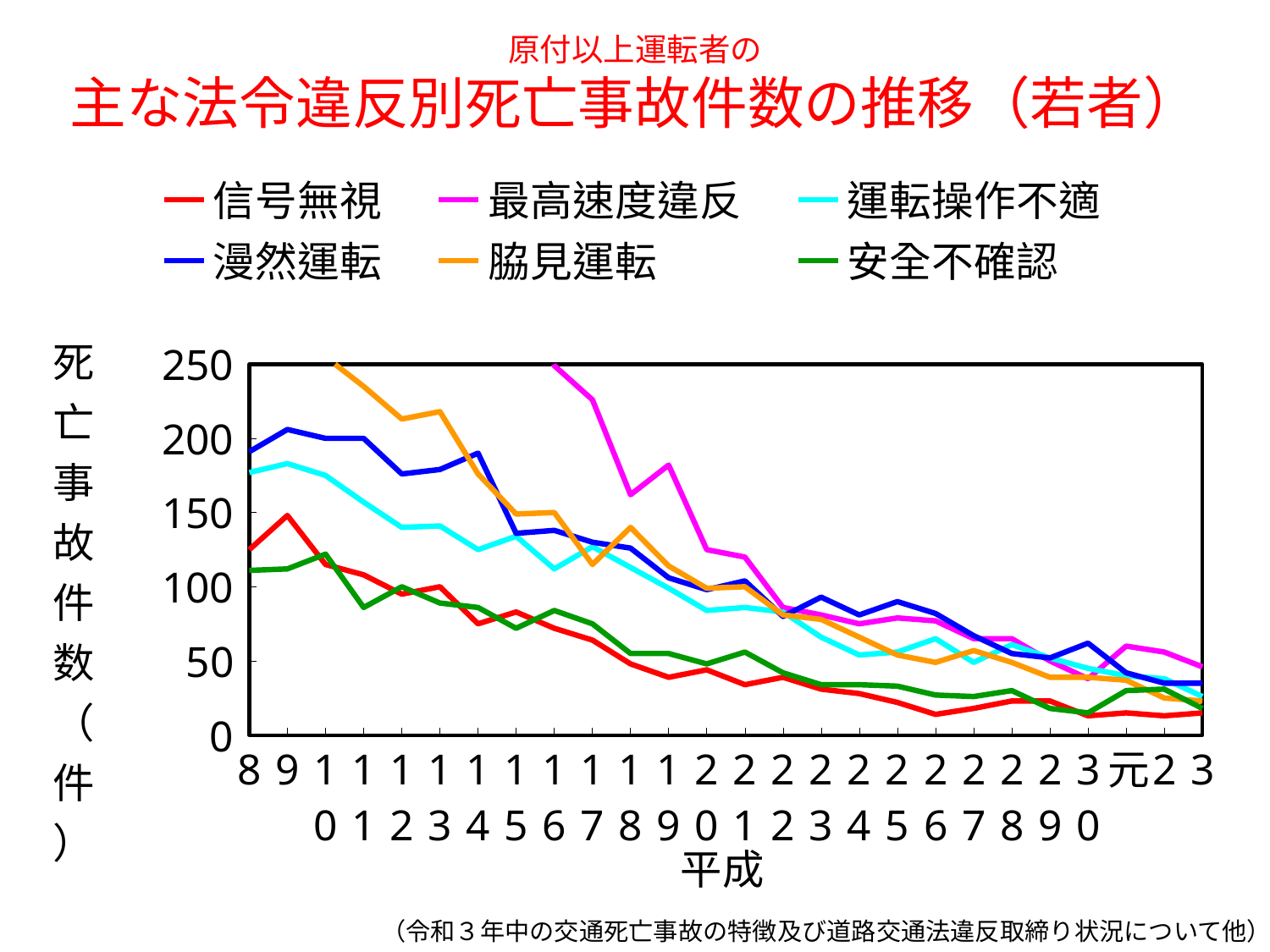
In 平成17, which is larger, the value for 最高速度違反 or the value for 漫然運転? 最高速度違反 Is the value for 漫然運転 in 令和3 greater or less than 50? less What kind of chart is shown on the slide? line chart Is the value for 最高速度違反 in 平成17 greater or less than 200? greater Overall, does the 信号無視 line rise or fall from 平成8 to 令和3? fall Is the value for 漫然運転 in 平成9 greater or less than 200? greater What colour is the line for 信号無視? red How many series does the legend list? 6 In 平成8, which is larger, the value for 漫然運転 or the value for 信号無視? 漫然運転 What is the title of the chart? 主な法令違反別死亡事故件数の推移（若者）